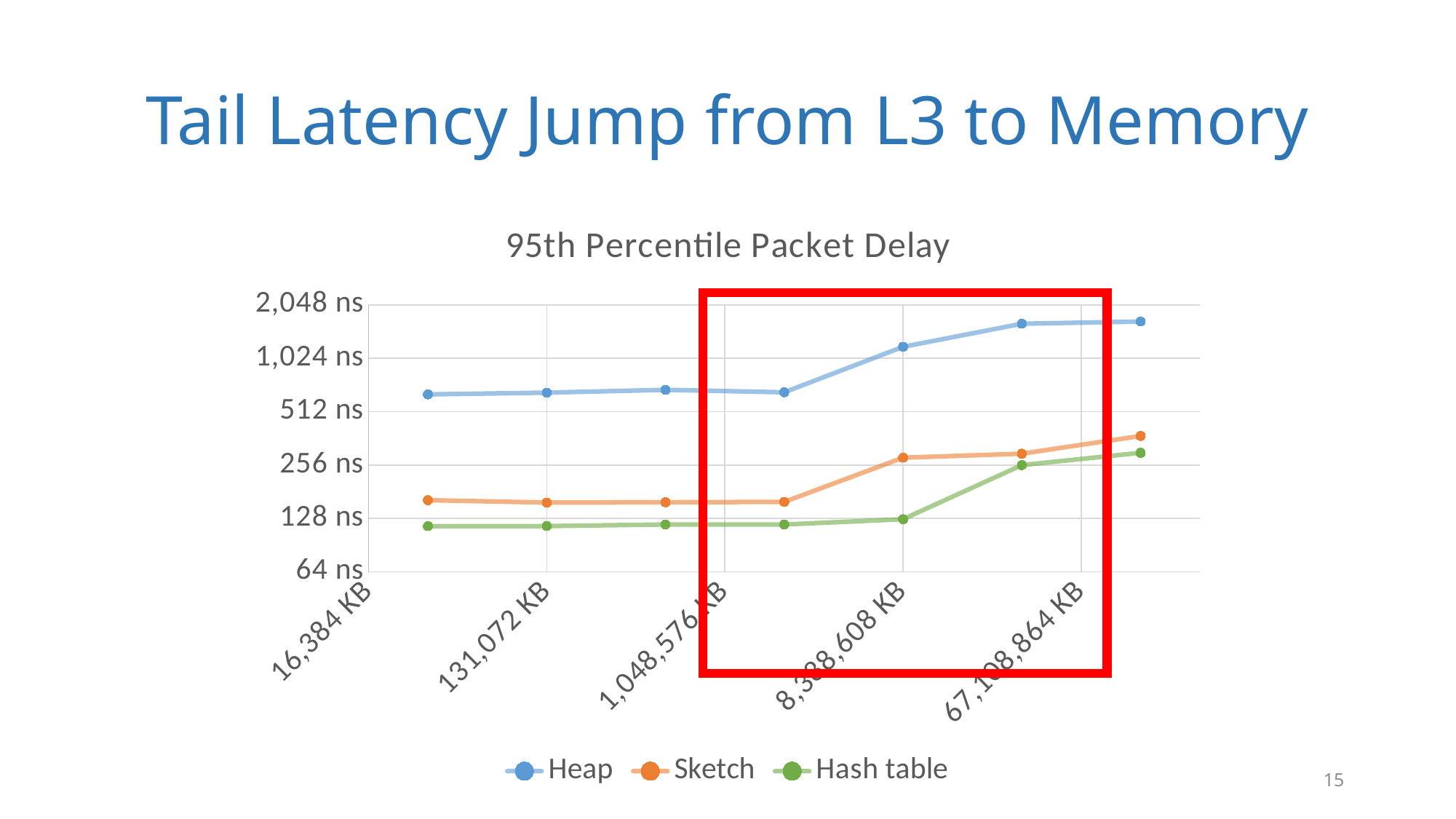
Which series has the highest 95th percentile packet delay across the chart? Heap What kind of chart is shown on the slide? line chart How many series does the legend list? 3 Which series has the lowest 95th percentile packet delay across the chart? Hash table How many data points are plotted for each series? 7 Do the Heap values rise or fall as the x axis moves from 16,384 KB to 67,108,864 KB? rise What is the title of the chart? 95th Percentile Packet Delay